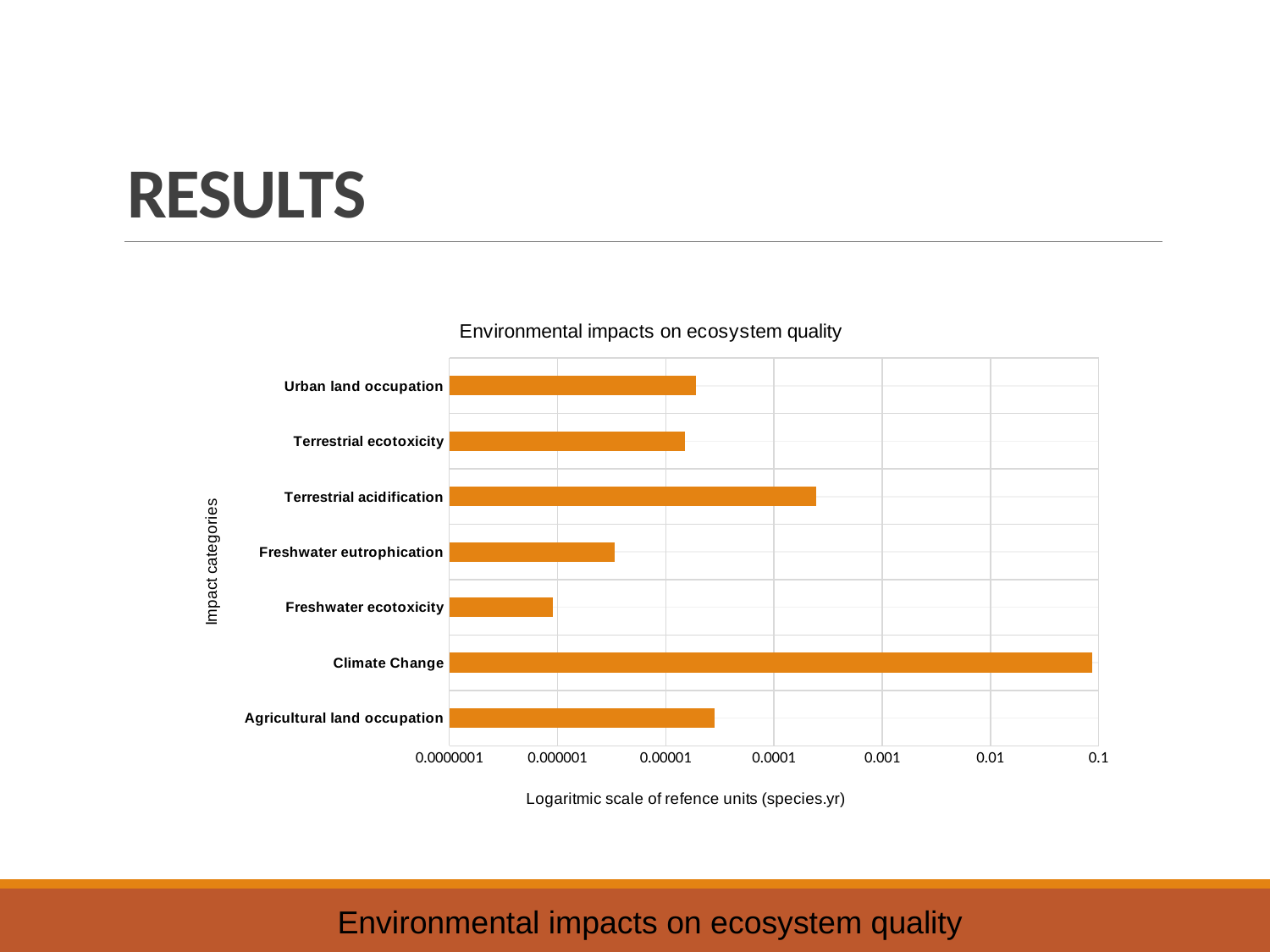
Which is larger, the value for Terrestrial acidification or the value for Urban land occupation? Terrestrial acidification Which impact category has the highest value? Climate Change Is the value for Freshwater eutrophication greater or less than 0.00001? less Is the value for Terrestrial acidification greater or less than 0.0001? greater Which is larger, the value for Freshwater eutrophication or the value for Freshwater ecotoxicity? Freshwater eutrophication Is the value for Urban land occupation greater or less than 0.00001? greater What kind of chart is shown on the slide? Bar chart How many impact categories are plotted in the chart? 7 What is the title of the chart? Environmental impacts on ecosystem quality Which impact category has the lowest value? Freshwater ecotoxicity